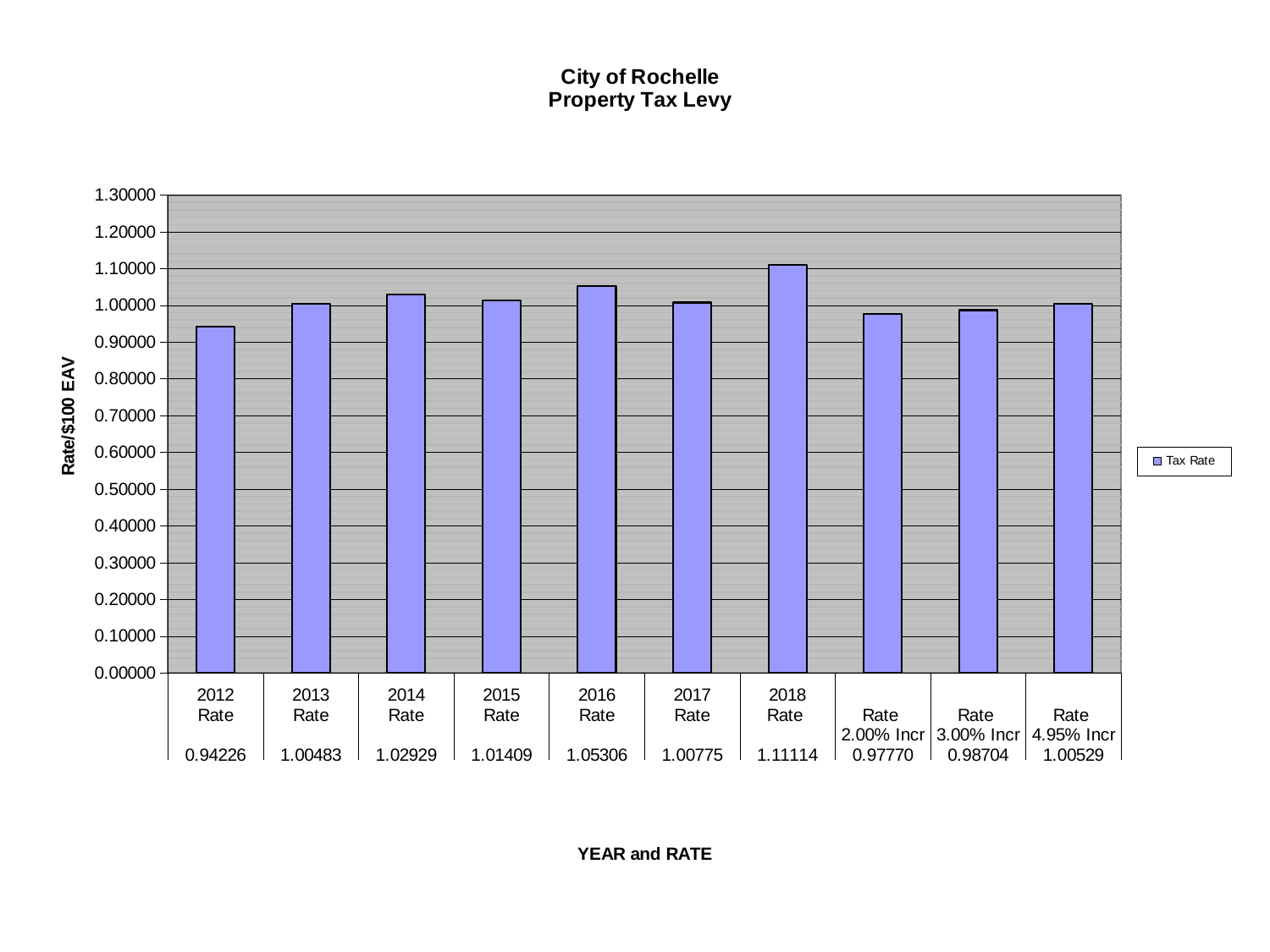
Which is larger, the tax rate for 2016 Rate or 2017 Rate? 2016 Rate Is the value for Rate 2.00% Incr greater or less than 1.00000? less Which category has the lowest tax rate? 2012 Rate What is the tax rate for 2018 Rate? 1.11114 What is the tax rate for 2012 Rate? 0.94226 What is the tax rate for Rate 3.00% Incr? 0.98704 How many bars are shown in the chart? 10 What is the label of the vertical axis? Rate/$100 EAV How many series does the legend list? 1 Which category has the highest tax rate? 2018 Rate What is the difference between the tax rate for 2018 Rate and 2012 Rate? 0.16888 What kind of chart is shown on the slide? Bar chart